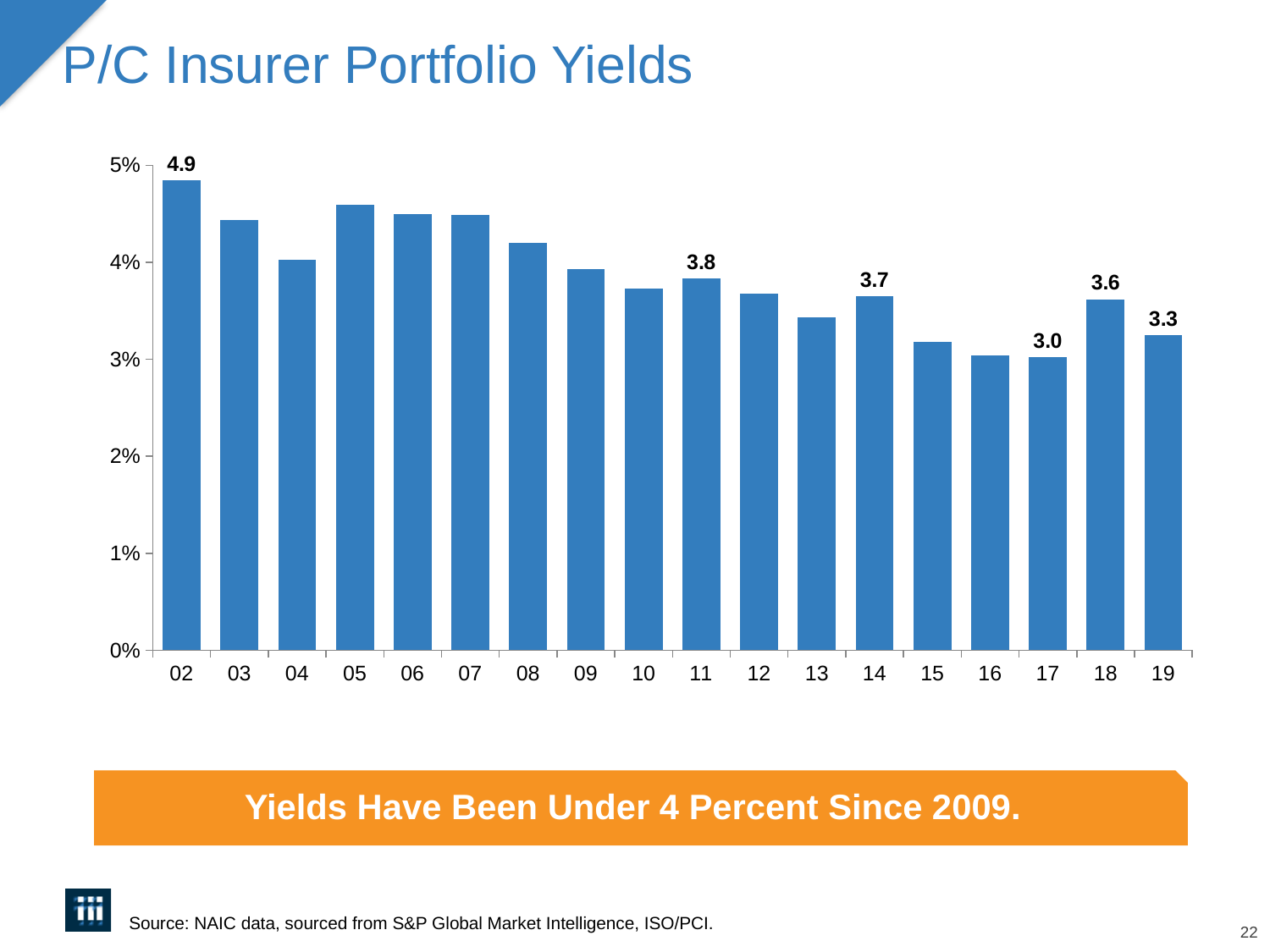
What kind of chart is shown on the slide? Bar chart What is the value for 02? 4.9 How many years are shown on the x axis? 18 Is the value for 05 greater or less than 4%? greater What is the difference between the values for 02 and 19? 1.6 What is the value for 17? 3.0 Which is larger, the value for 18 or the value for 19? 18 Is the value for 13 greater or less than 4%? less What is the difference between the values for 18 and 17? 0.6 What is the value for 19? 3.3 Which year has the highest portfolio yield? 02 Do the yields generally rise or fall from 02 to 19? Fall